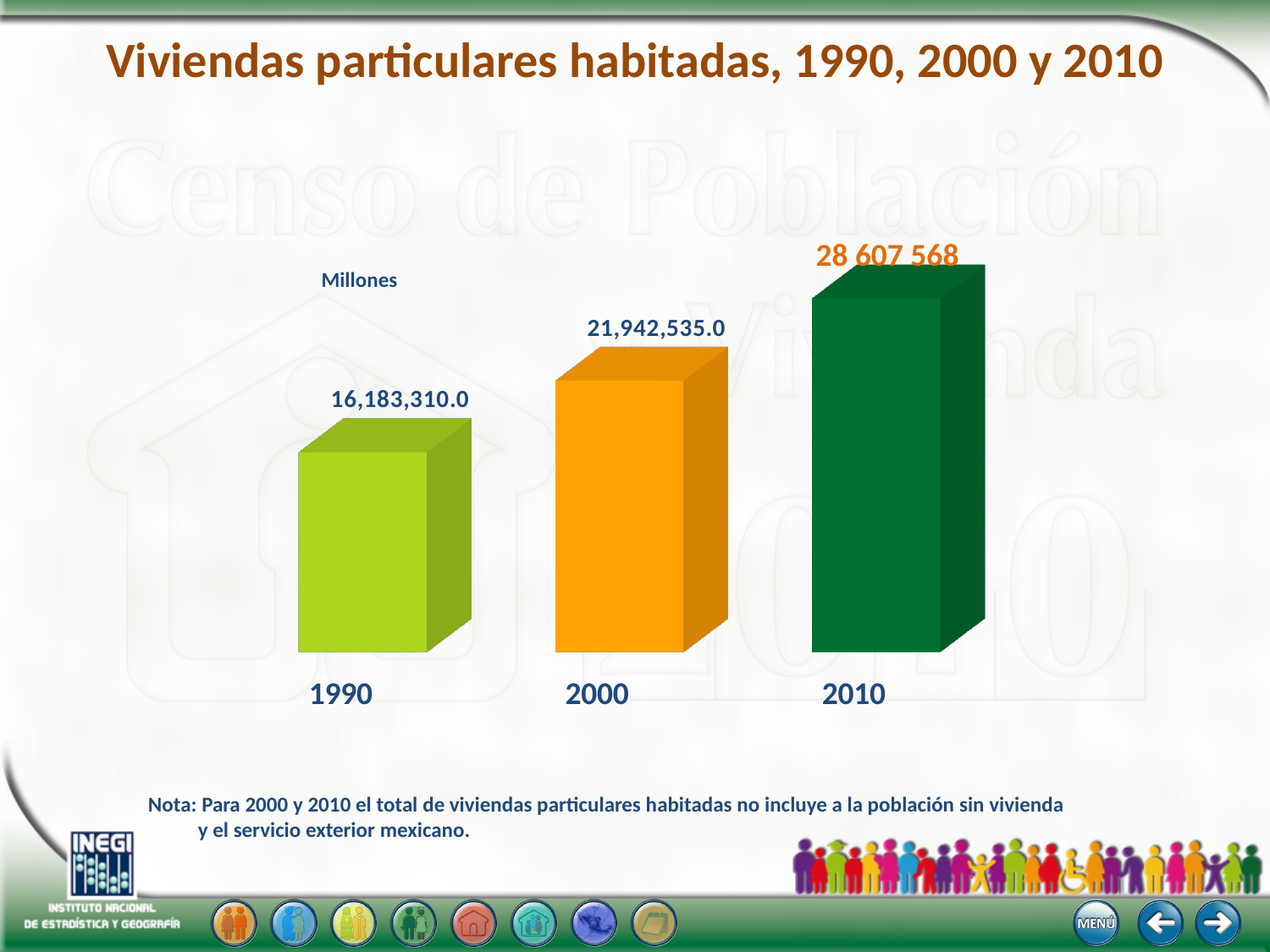
What is the value shown for 1990? 16,183,310.0 What is the value shown for 2000? 21,942,535.0 Do the values rise or fall from 1990 to 2010? Rise What kind of chart is shown on the slide? Bar chart What is the value shown for 2010? 28 607 568 Which is larger, the value for 1990 or the value for 2000? 2000 Which year has the lowest value? 1990 How many years (categories) are shown in the chart? 3 What is the title of the chart? Viviendas particulares habitadas, 1990, 2000 y 2010 What is the difference between the values for 2010 and 2000? 6,665,033 What is the difference between the values for 2000 and 1990? 5,759,225.0 Which year has the highest value? 2010